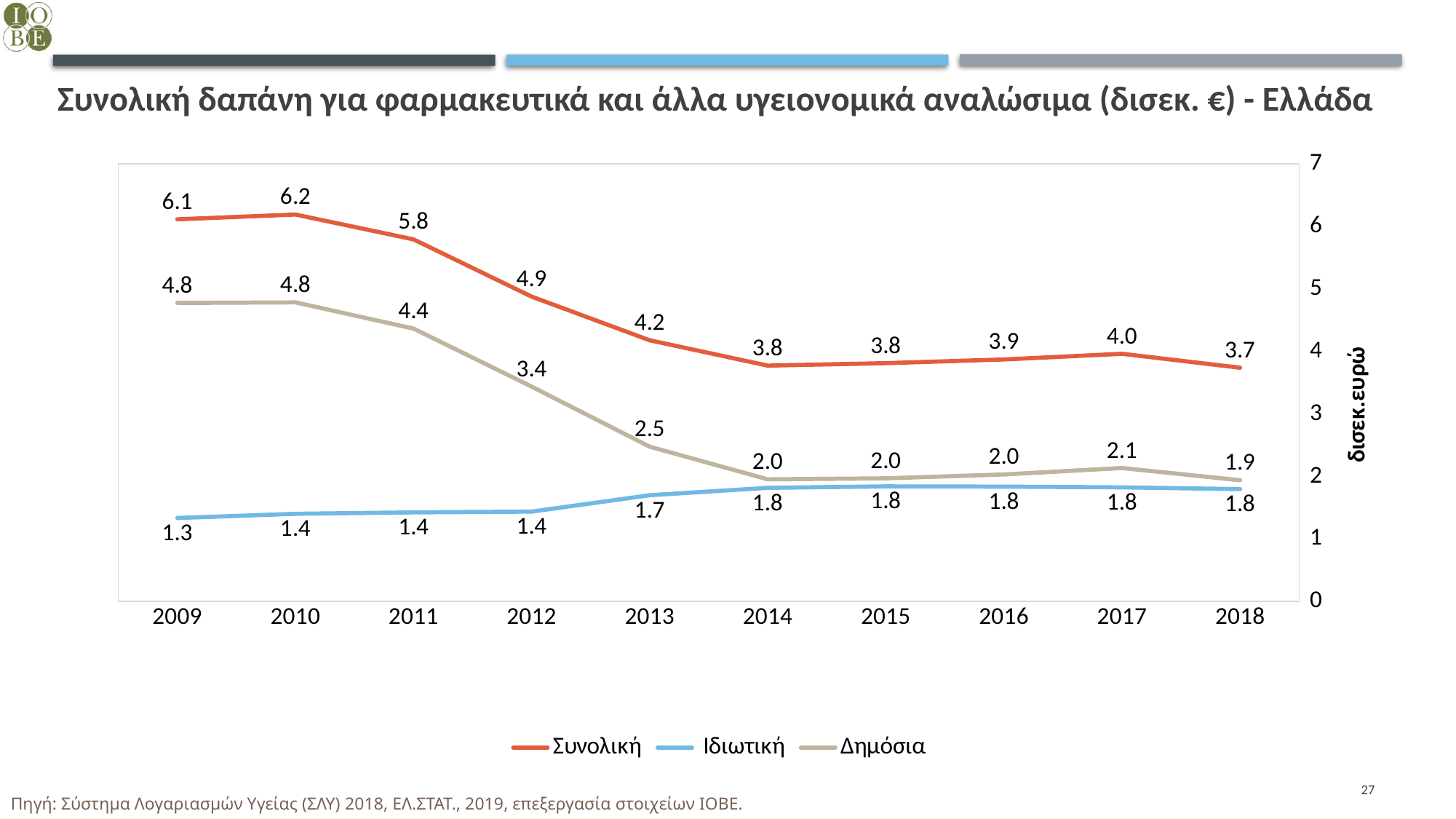
What type of chart is shown on the slide? line chart Does Δημόσια rise or fall from 2010 to 2014? fall In which year is Συνολική at its lowest? 2018 What is the value of Ιδιωτική in 2009? 1.3 In which year is Συνολική at its highest? 2010 What is the difference between Συνολική in 2009 and in 2018? 2.4 What is the value of Συνολική in 2010? 6.2 How many years are shown on the x axis? 10 Which is larger in 2012, Δημόσια or Ιδιωτική? Δημόσια What is the value of Δημόσια in 2013? 2.5 How many series does the legend list? 3 What is the label of the vertical axis? δισεκ.ευρώ